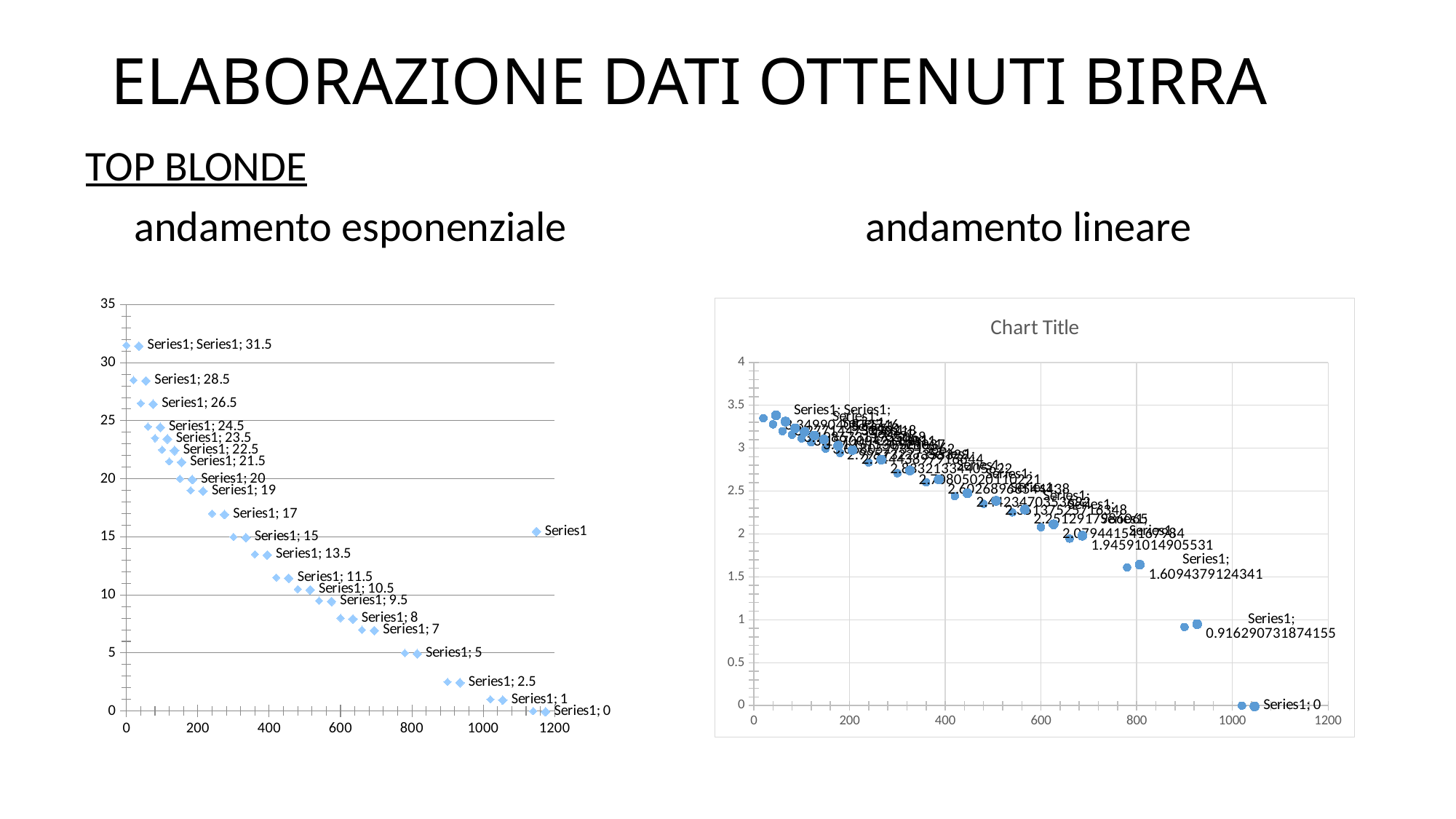
In the 'andamento lineare' chart on the right, what is the title printed above the plot? Chart Title In the 'andamento esponenziale' chart on the left, do the values rise or fall as x increases? fall In the 'andamento esponenziale' chart on the left, what is the maximum value shown on the y axis? 35 In the 'andamento esponenziale' chart on the left, what is the difference between the two highest labelled values, 31.5 and 28.5? 3 In the 'andamento esponenziale' chart on the left, what is the highest labelled data value? 31.5 In the 'andamento lineare' chart on the right, what is the labelled value of the points near x = 900? 0.916290731874155 In the 'andamento lineare' chart on the right, are the values of the points near x = 50 greater or less than 3? greater In the 'andamento lineare' chart on the right, what is the labelled value of the points near x = 800? 1.6094379124341 In the 'andamento lineare' chart on the right, what is the lowest labelled data value? 0 In the 'andamento esponenziale' chart on the left, what is the lowest labelled data value? 0 What kind of chart is the 'andamento esponenziale' chart on the left? scatter chart What kind of chart is the 'andamento lineare' chart on the right? scatter chart